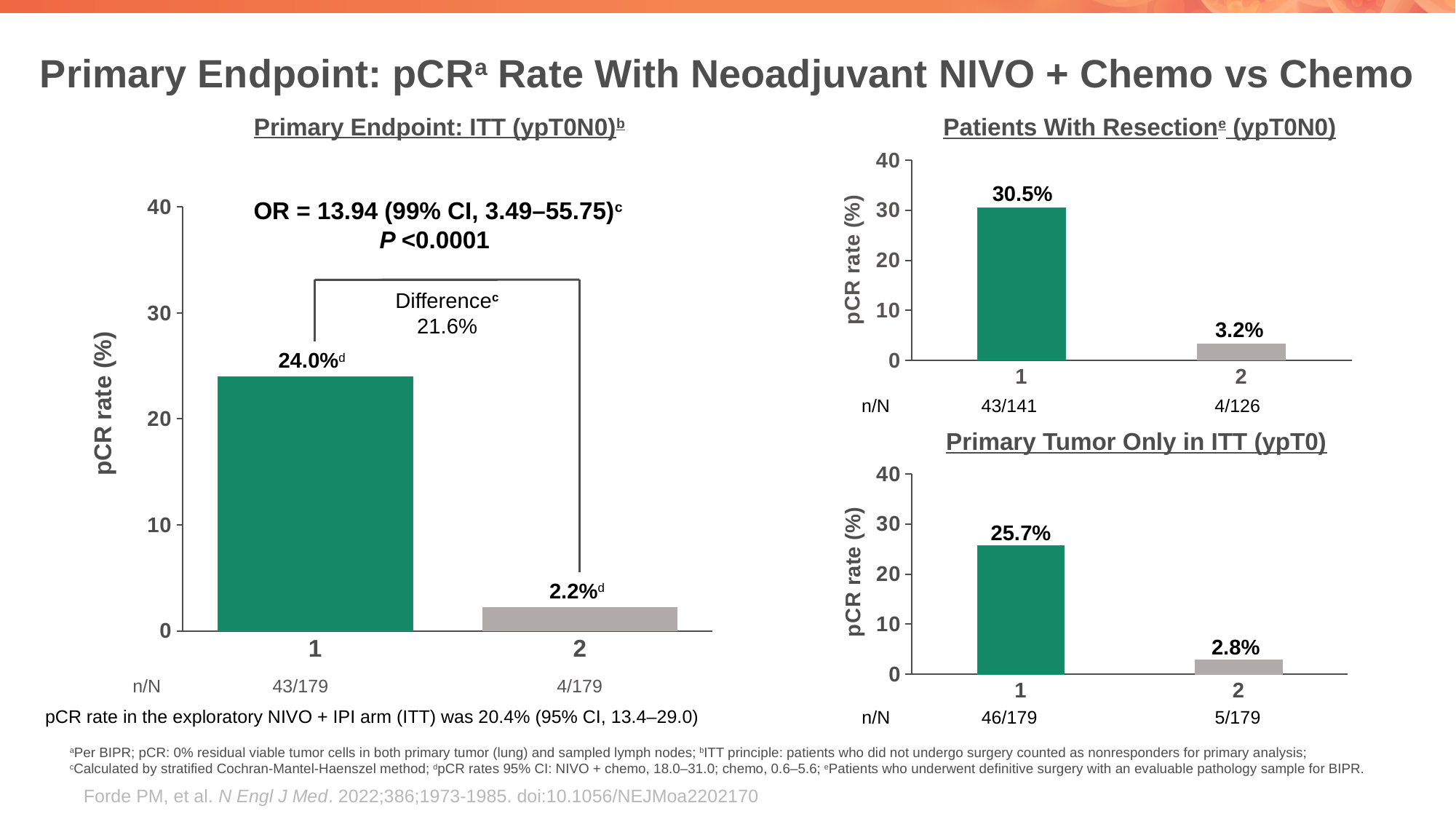
What kind of chart is the 'Primary Tumor Only in ITT (ypT0)' chart? Bar chart In the 'Primary Tumor Only in ITT (ypT0)' chart, what is the pCR rate for category 1? 25.7% In the 'Patients With Resection (ypT0N0)' chart, what is the pCR rate for category 1? 30.5% In the 'Primary Tumor Only in ITT (ypT0)' chart, which category has the lowest pCR rate? 2 In the 'Primary Endpoint: ITT (ypT0N0)' chart, is the pCR rate for category 1 greater or less than 20? greater In the 'Primary Tumor Only in ITT (ypT0)' chart, what is the pCR rate for category 2? 2.8% How many bars are shown in the 'Patients With Resection (ypT0N0)' chart? 2 In the 'Primary Endpoint: ITT (ypT0N0)' chart, what is the pCR rate for category 1? 24.0% In the 'Patients With Resection (ypT0N0)' chart, what is the pCR rate for category 2? 3.2% In the 'Patients With Resection (ypT0N0)' chart, which category has the highest pCR rate? 1 In the 'Primary Endpoint: ITT (ypT0N0)' chart, what is the pCR rate for category 2? 2.2% In the 'Primary Endpoint: ITT (ypT0N0)' chart, what is the difference between the pCR rates of category 1 and category 2? 21.8%